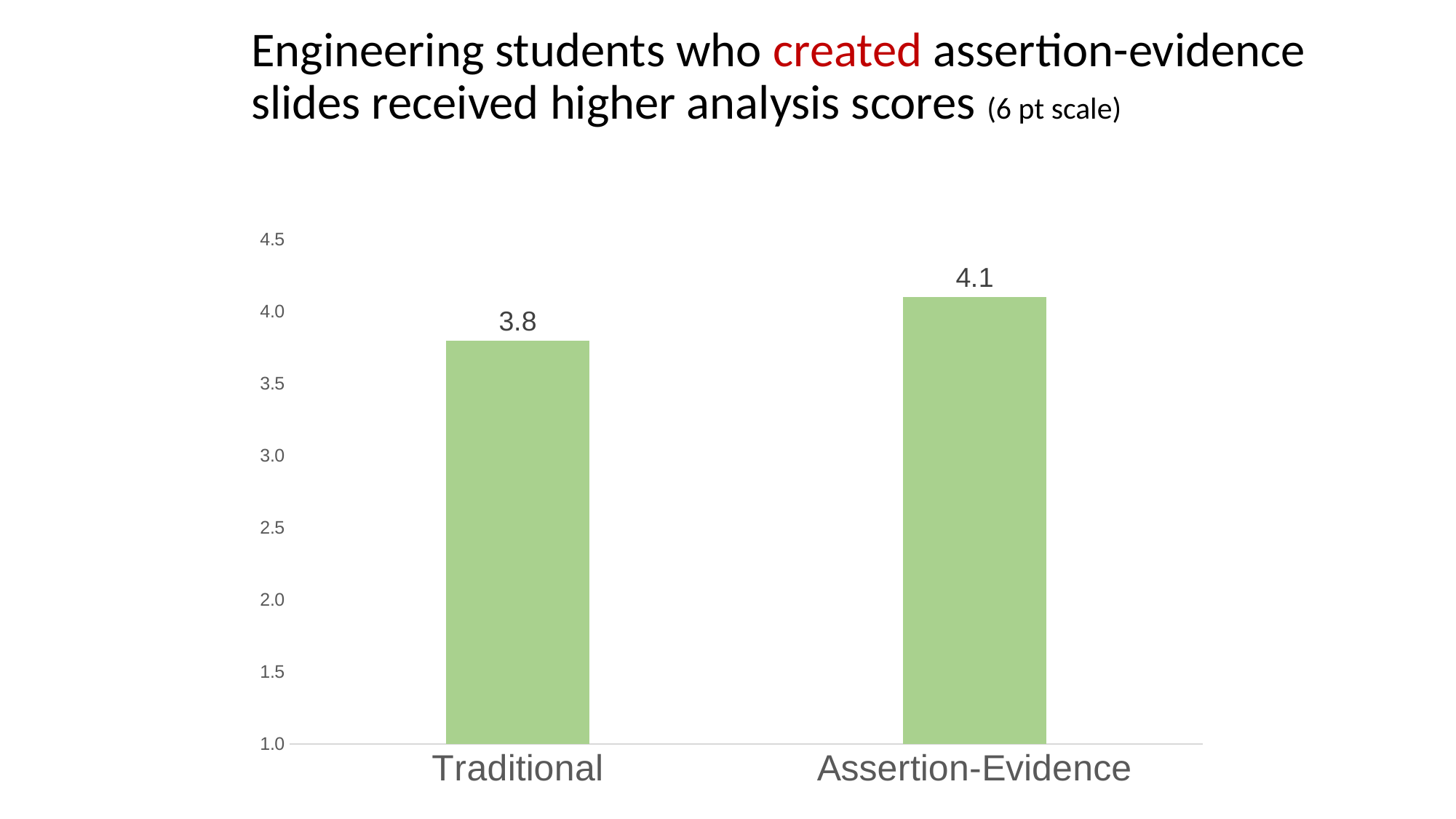
Which category has the highest analysis score? Assertion-Evidence Is the value for Assertion-Evidence greater or less than 4.0? greater Which is larger, the score for Traditional or the score for Assertion-Evidence? Assertion-Evidence What is the lowest value shown on the y axis? 1.0 Which category has the lowest analysis score? Traditional What is the difference between the Assertion-Evidence score and the Traditional score? 0.3 How many categories are shown on the x axis? 2 What colour are the bars in the chart? green What kind of chart is shown on the slide? bar chart What is the analysis score for Traditional? 3.8 What is the analysis score for Assertion-Evidence? 4.1 Is the value for Traditional greater or less than 4.0? less